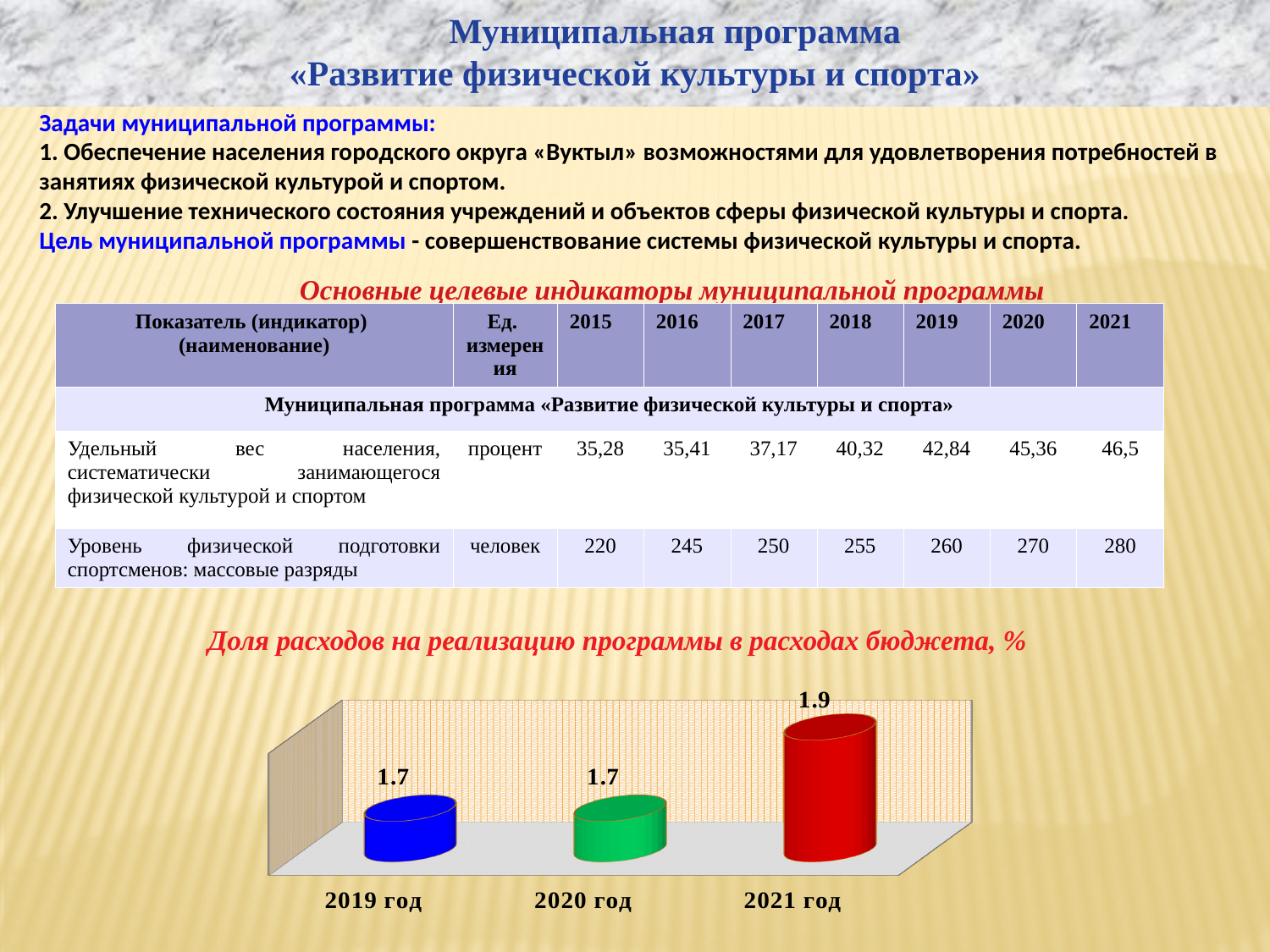
Which year has the highest value in the chart? 2021 год What is the value for 2020 год in the chart? 1.7 What is the value for 2021 год in the chart? 1.9 Are the values for 2019 год and 2020 год equal? Yes How many categories are shown in the chart? 3 What colour is the bar for 2021 год? Red Do the values rise or fall from 2019 год to 2021 год? Rise Which is larger, the value for 2021 год or the value for 2020 год? 2021 год What is the title of the chart? Доля расходов на реализацию программы в расходах бюджета, % What is the difference between the values for 2021 год and 2019 год? 0.2 What kind of chart is shown on the slide? Bar chart What is the value for 2019 год in the chart? 1.7